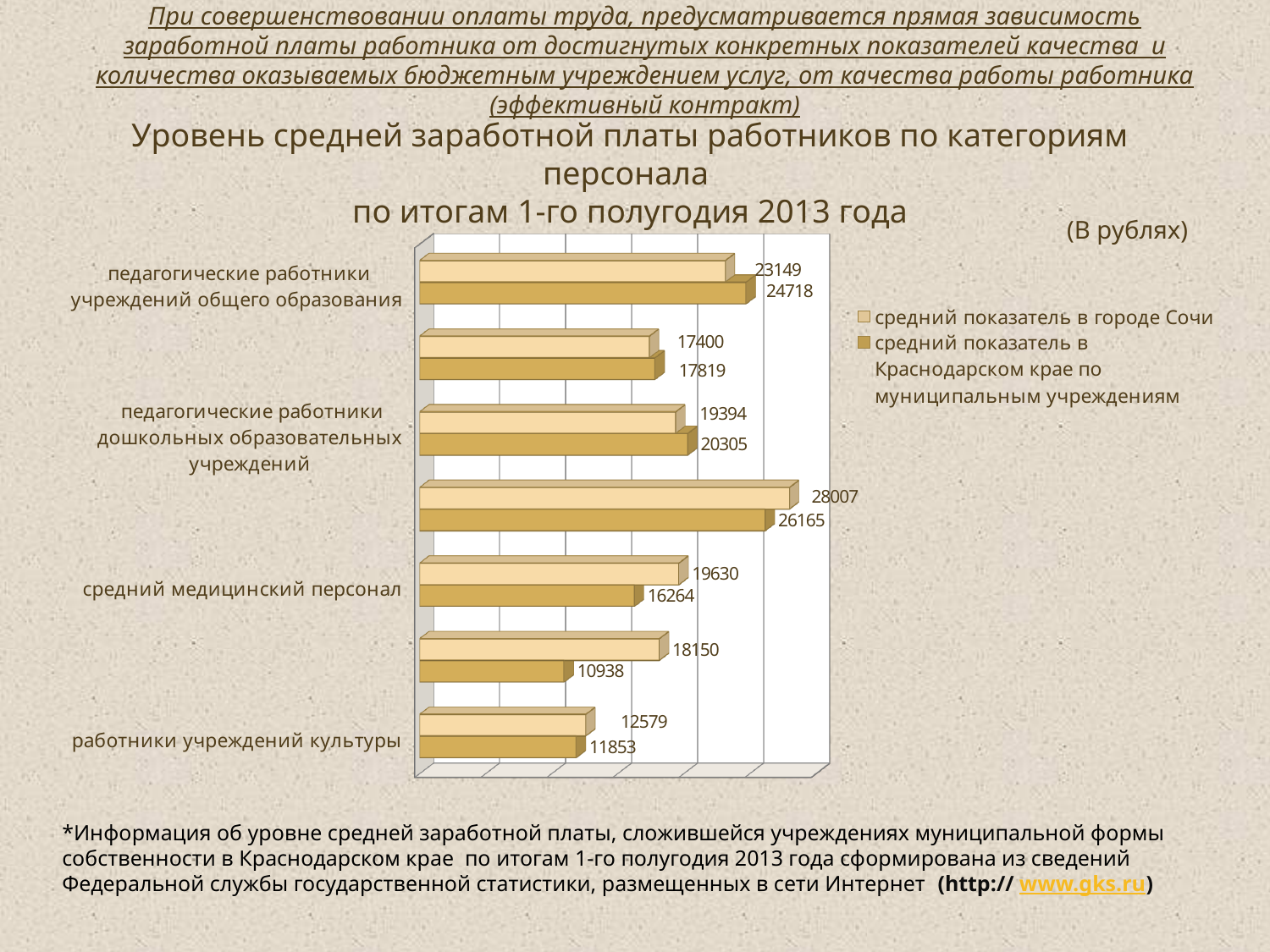
In what units are the values on the chart given? rubles (В рублях) What is the average salary in Krasnodar Krai municipal institutions for педагогические работники учреждений общего образования? 24718 What is the difference between the Krasnodar Krai and Sochi values for педагогические работники дошкольных образовательных учреждений? 911 How many series does the legend list? 2 For работники учреждений культуры, which is larger: the Sochi value or the Krasnodar Krai value? the Sochi value What is the Krasnodar Krai value for средний медицинский персонал? 16264 What is the largest value labeled on the chart? 28007 What is the Sochi value for работники учреждений культуры? 12579 What is the difference between the Sochi and Krasnodar Krai values for средний медицинский персонал? 3366 What is the Sochi value for педагогические работники дошкольных образовательных учреждений? 19394 What kind of chart is shown on the slide? bar chart What is the average salary in Sochi for педагогические работники учреждений общего образования? 23149